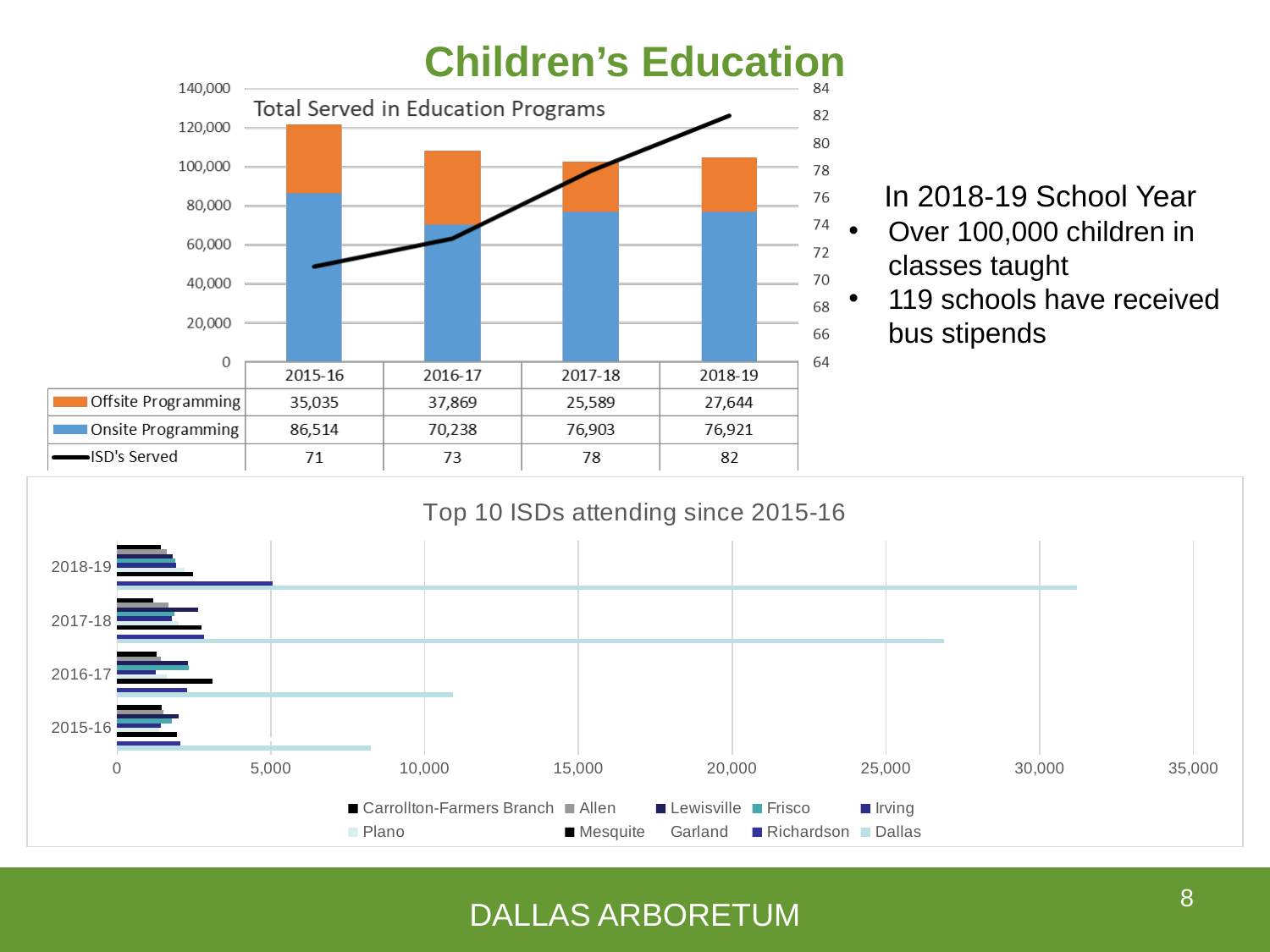
In the 'Total Served in Education Programs' chart, does the ISD's Served line rise or fall from 2015-16 to 2018-19? rises In the 'Total Served in Education Programs' chart, which year has the lowest Offsite Programming value? 2017-18 In the 'Total Served in Education Programs' chart, what is the Onsite Programming value for 2015-16? 86,514 In the 'Total Served in Education Programs' chart, what is the Offsite Programming value for 2017-18? 25,589 In the 'Top 10 ISDs attending since 2015-16' chart, how many ISDs are listed in the legend? 10 In the 'Total Served in Education Programs' chart, what is the total of the stacked bar for 2015-16 (Onsite plus Offsite Programming)? 121,549 In the 'Top 10 ISDs attending since 2015-16' chart, is the value for Dallas in 2018-19 greater or less than 30,000? greater In the 'Total Served in Education Programs' chart, what is the difference between the Onsite Programming values for 2018-19 and 2017-18? 18 In the 'Total Served in Education Programs' chart, how many ISD's were served in 2018-19? 82 What kind of chart is 'Top 10 ISDs attending since 2015-16'? bar chart In the 'Total Served in Education Programs' chart, which year has the highest Onsite Programming value? 2015-16 In the 'Total Served in Education Programs' chart, how many series are listed in the legend? 3